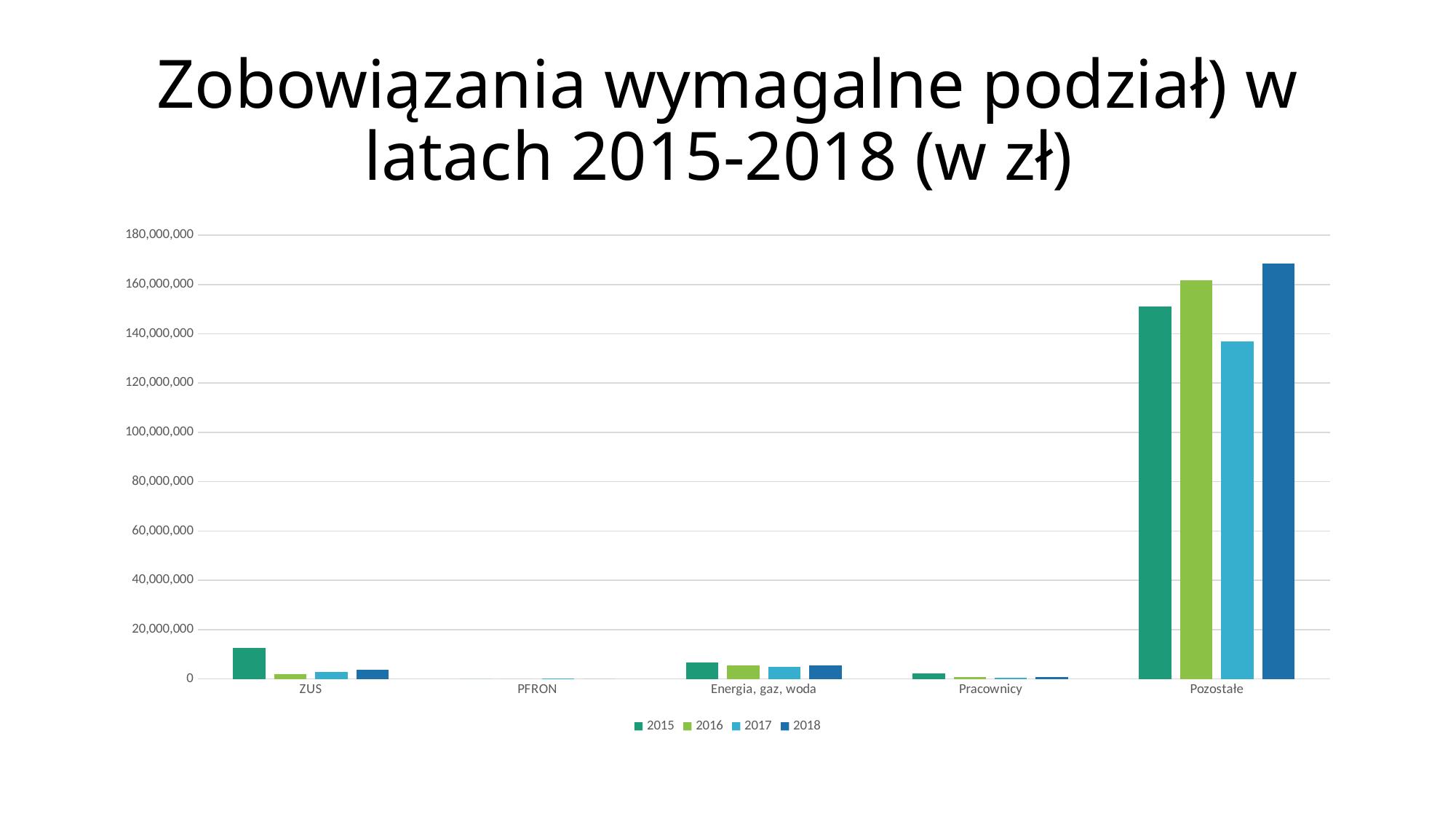
Which category has the lowest values across all years? PFRON How many series does the legend list? 4 Is the 2018 value for Pozostałe greater or less than 160,000,000? greater Which category has the highest value for 2018? Pozostałe What kind of chart is shown on the slide? bar chart For ZUS, which is larger: the 2015 value or the 2016 value? 2015 What are the entries listed in the legend? 2015, 2016, 2017, 2018 Is the 2017 value for Pozostałe greater or less than 140,000,000? less For Pozostałe, which is larger: the 2015 value or the 2016 value? 2016 How many categories are shown on the x axis? 5 Is the 2015 value for ZUS greater or less than 20,000,000? less For Pozostałe, which year has the highest value? 2018